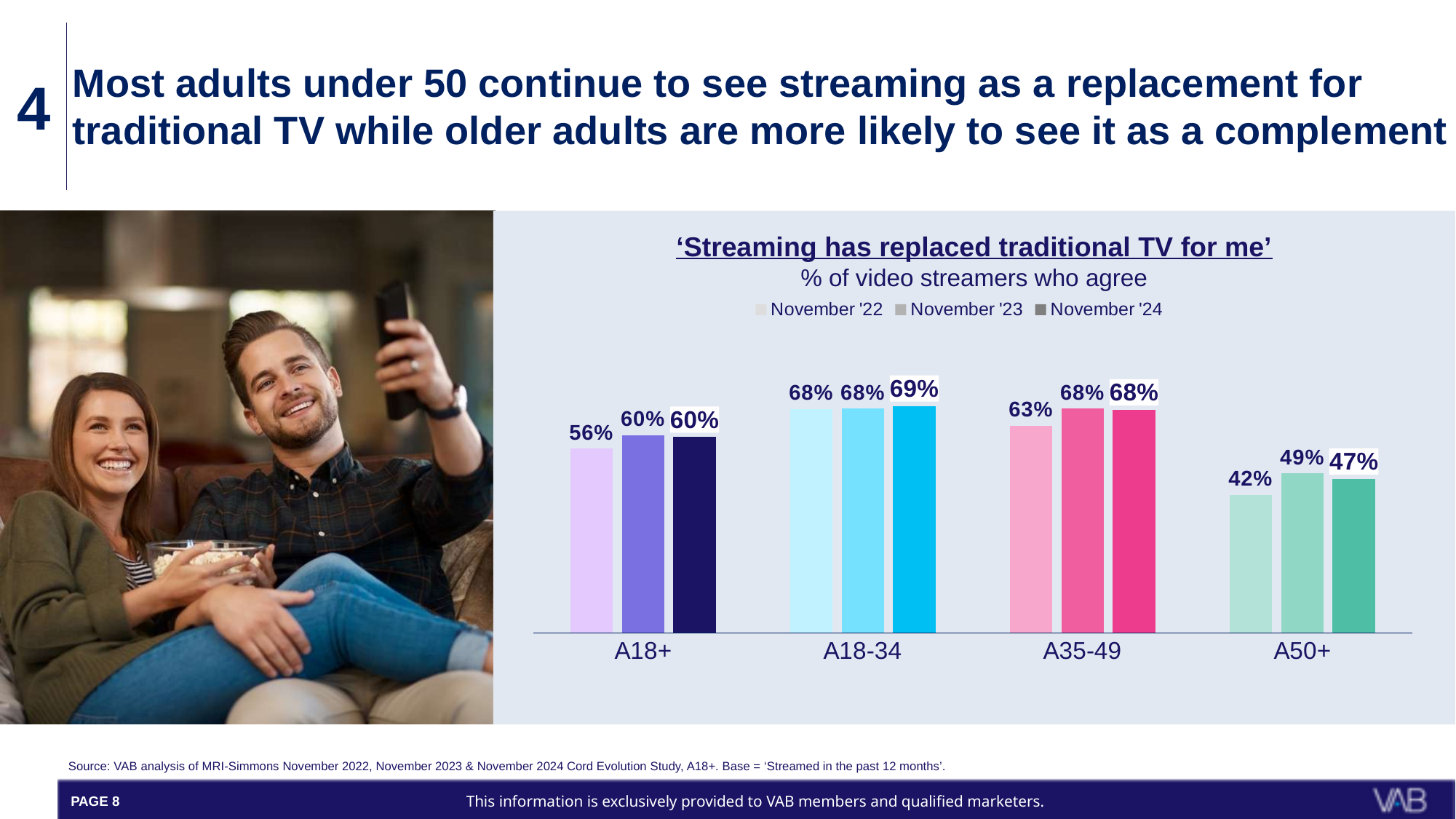
What is the November '23 value for A35-49? 68% What is the difference between the November '24 values for A18-34 and A50+? 22 percentage points What is the difference between the November '23 and November '22 values for A35-49? 5 percentage points How many series does the legend list? 3 How many age groups are shown on the x axis? 4 Which is larger for A50+: the November '23 value or the November '24 value? November '23 What is the November '22 value for A18+? 56% Which age group has the highest November '24 value? A18-34 What kind of chart is shown? Bar chart Which age group has the lowest November '24 value? A50+ What is the November '22 value for A50+? 42% What is the November '24 value for A18-34? 69%